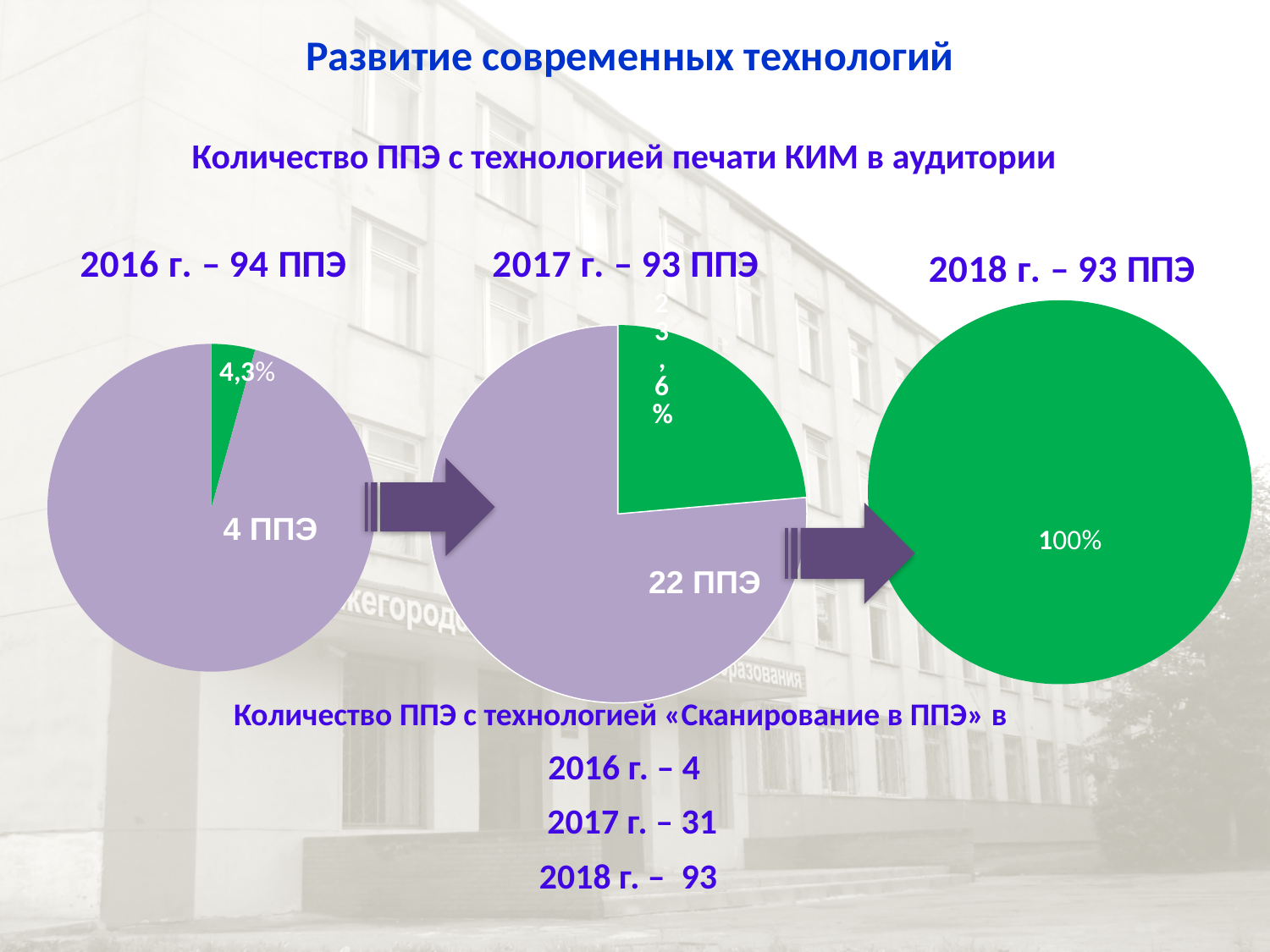
How many slices does the 2017 г. – 93 ППЭ pie chart have? 2 In the 2018 г. – 93 ППЭ pie chart, what percentage is printed on the pie? 100% What kind of chart is used for the 2016 г. – 94 ППЭ data? pie chart In the 2017 г. – 93 ППЭ pie chart, what percentage is printed on the green slice? 23,6% Which pie chart has the larger green slice, 2016 г. – 94 ППЭ or 2017 г. – 93 ППЭ? 2017 г. – 93 ППЭ What is the title printed above the leftmost pie chart? 2016 г. – 94 ППЭ In the 2017 г. – 93 ППЭ pie chart, what label is printed on the purple slice? 22 ППЭ How many pie charts are shown on the slide? 3 In the 2016 г. – 94 ППЭ pie chart, what percentage is printed on the green slice? 4,3% In the 2016 г. – 94 ППЭ pie chart, what label is printed on the large purple slice? 4 ППЭ Does the green share of the pie charts rise or fall from 2016 to 2018? rise What colour is the 2018 г. – 93 ППЭ pie chart? green